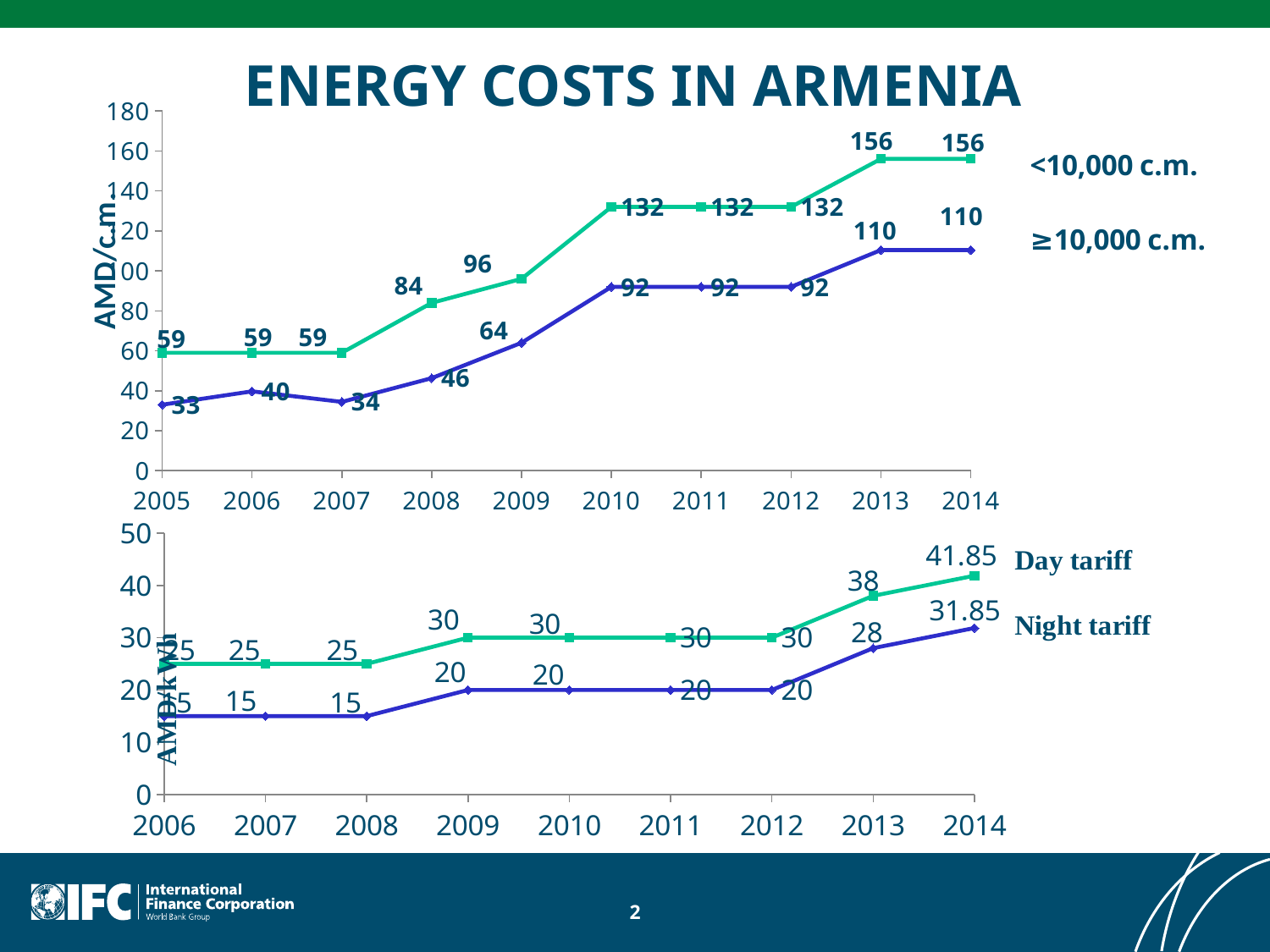
In the bottom chart, what is the Night tariff in 2013? 28 In the top chart, what is the difference between the <10,000 c.m. and ≥10,000 c.m. values in 2014? 46 How many series does the legend of the top chart list? 2 In the bottom chart, which is larger in 2009, the Day tariff or the Night tariff? Day tariff What type of chart is the bottom chart? line chart In the top chart, does the <10,000 c.m. series generally rise or fall from 2005 to 2014? rise In the bottom chart, what is the Day tariff in 2014? 41.85 In the top chart, how many years are shown on the x axis? 10 In the top chart, in which year is the ≥10,000 c.m. series lowest? 2005 In the top chart, what is the value for ≥10,000 c.m. in 2009? 64 In the bottom chart, what is the difference between the Day tariff and the Night tariff in 2012? 10 In the top chart, what is the value for <10,000 c.m. in 2010? 132